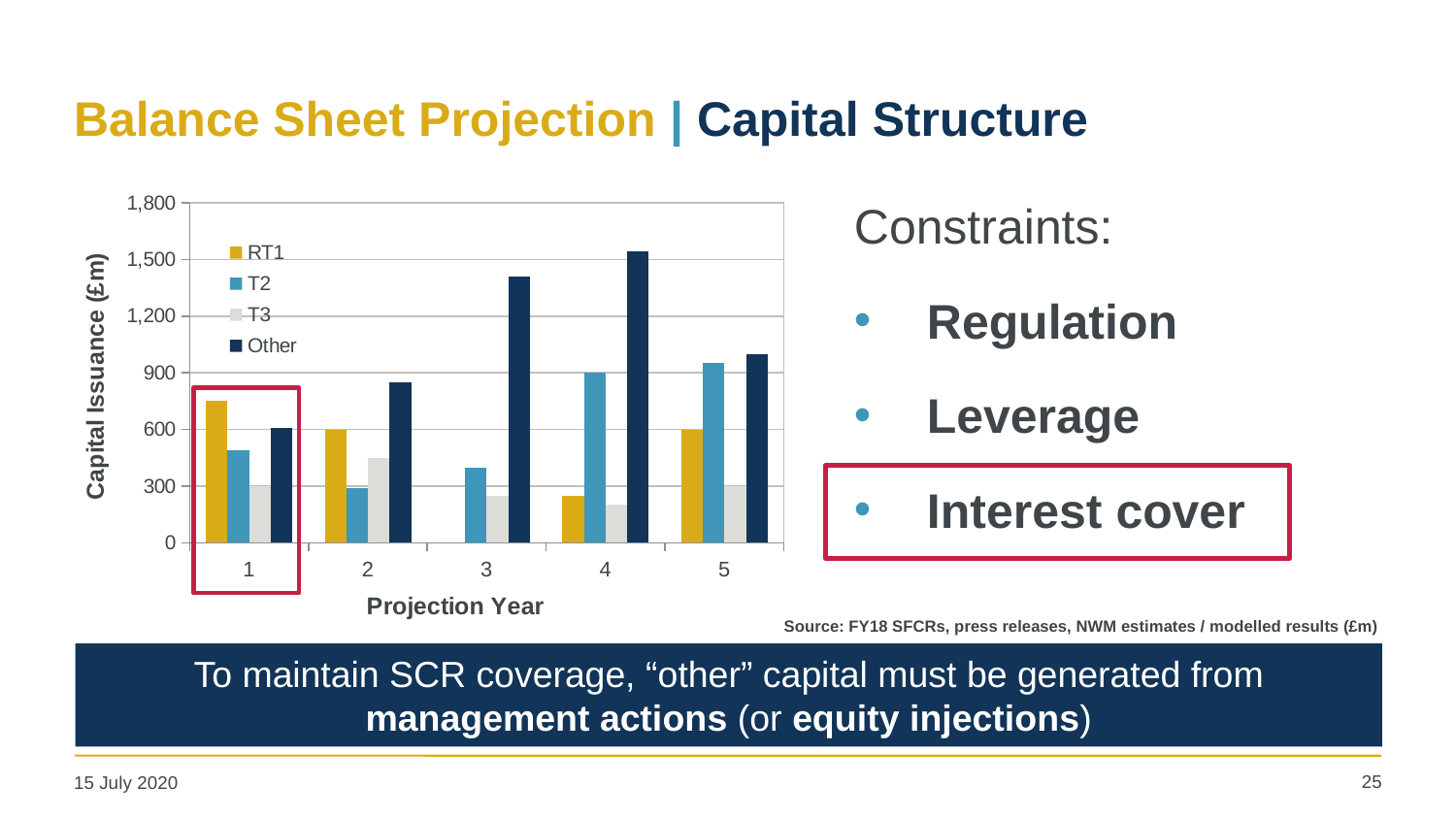
How many series does the chart legend list? 4 What is the title of the y axis? Capital Issuance (£m) In projection year 1, which is larger: RT1 or Other? RT1 Does the Other series rise or fall from projection year 1 to projection year 4? Rise Which series has the lowest bar in projection year 4? T3 How many projection years are shown on the x axis? 5 Is the value for Other in projection year 3 greater or less than 1,200? greater In projection year 4, which is larger: T2 or RT1? T2 Is the value for RT1 in projection year 1 greater or less than 600? greater In which projection year is the Other bar the highest? 4 What kind of chart is shown on the slide? Bar chart